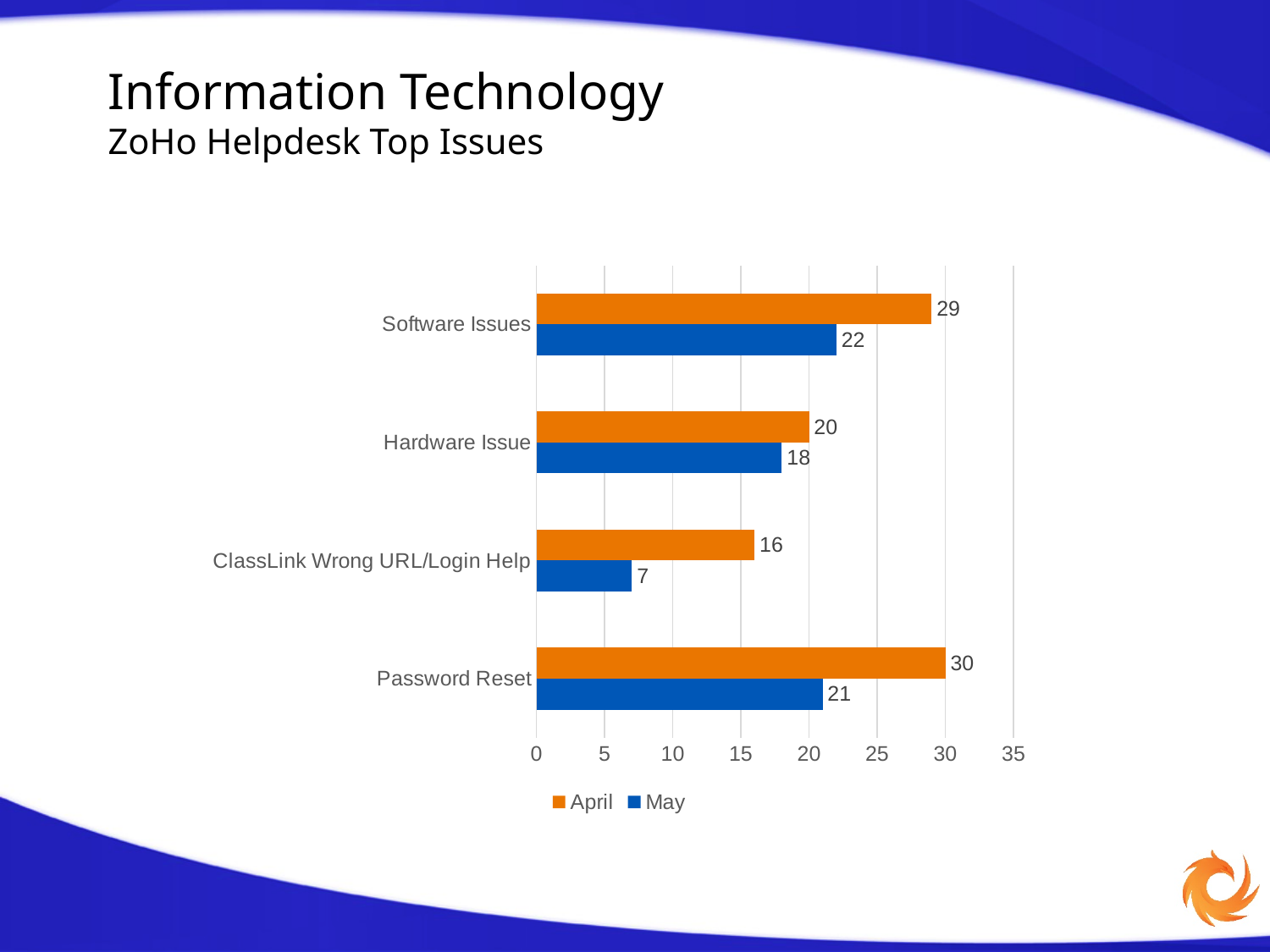
How many categories are shown on the chart? 4 What is the difference between the April and May values for ClassLink Wrong URL/Login Help? 9 Which is larger, the May value for Hardware Issue or the May value for Password Reset? Password Reset What is the May value for Password Reset? 21 What is the April value for Software Issues? 29 What kind of chart is shown on the slide? Bar chart What is the May value for ClassLink Wrong URL/Login Help? 7 Which category has the lowest May value? ClassLink Wrong URL/Login Help Which category has the highest April value? Password Reset What is the difference between the April and May values for Software Issues? 7 How many series does the legend list? 2 Which colour represents the May series? Blue